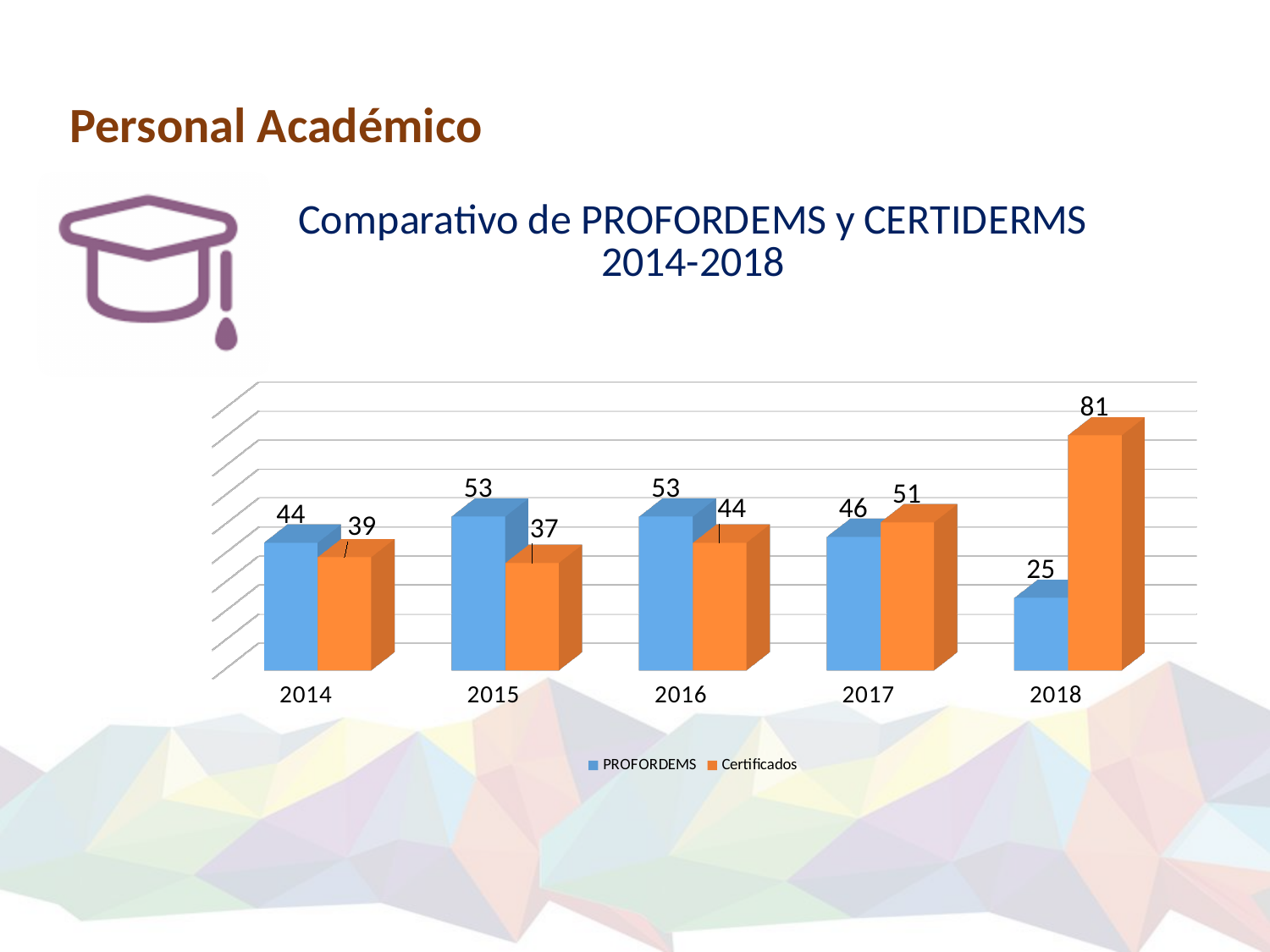
Which year has the highest Certificados value? 2018 What kind of chart is shown on the slide? Bar chart How many series does the legend list? 2 What is the Certificados value for 2018? 81 How many years are shown on the x axis? 5 What is the Certificados value for 2015? 37 What is the title of the chart? Comparativo de PROFORDEMS y CERTIDERMS 2014-2018 Which year has the lowest PROFORDEMS value? 2018 What is the difference between the Certificados and PROFORDEMS values in 2018? 56 What is the PROFORDEMS value for 2014? 44 Does the Certificados value rise or fall from 2017 to 2018? Rise In 2016, which series has the larger value, PROFORDEMS or Certificados? PROFORDEMS